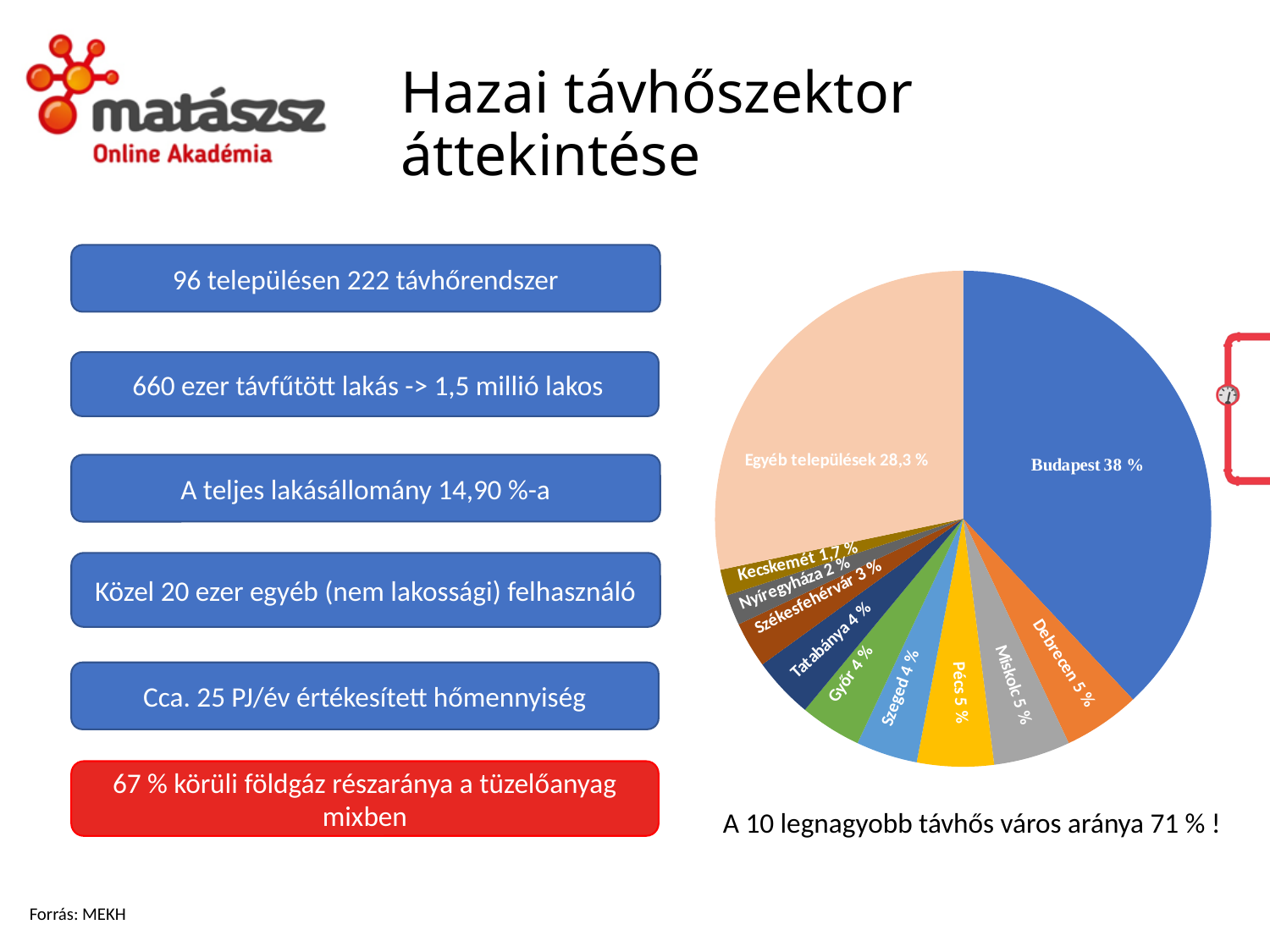
Which slice of the pie is the smallest? Kecskemét What share of the pie does Egyéb települések have? 28,3 % What share of the pie does Székesfehérvár have? 3 % What share of the pie does Kecskemét have? 1,7 % Which has a larger share, Debrecen or Szeged? Debrecen What share of the pie does Nyíregyháza have? 2 % What is the difference between the shares of Tatabánya and Nyíregyháza? 2 % What kind of chart is shown on the slide? pie chart What share of the pie does Budapest have? 38 % Which slice of the pie is the largest? Budapest How many slices does the pie chart have? 11 What is the difference between the shares of Budapest and Egyéb települések? 9,7 %